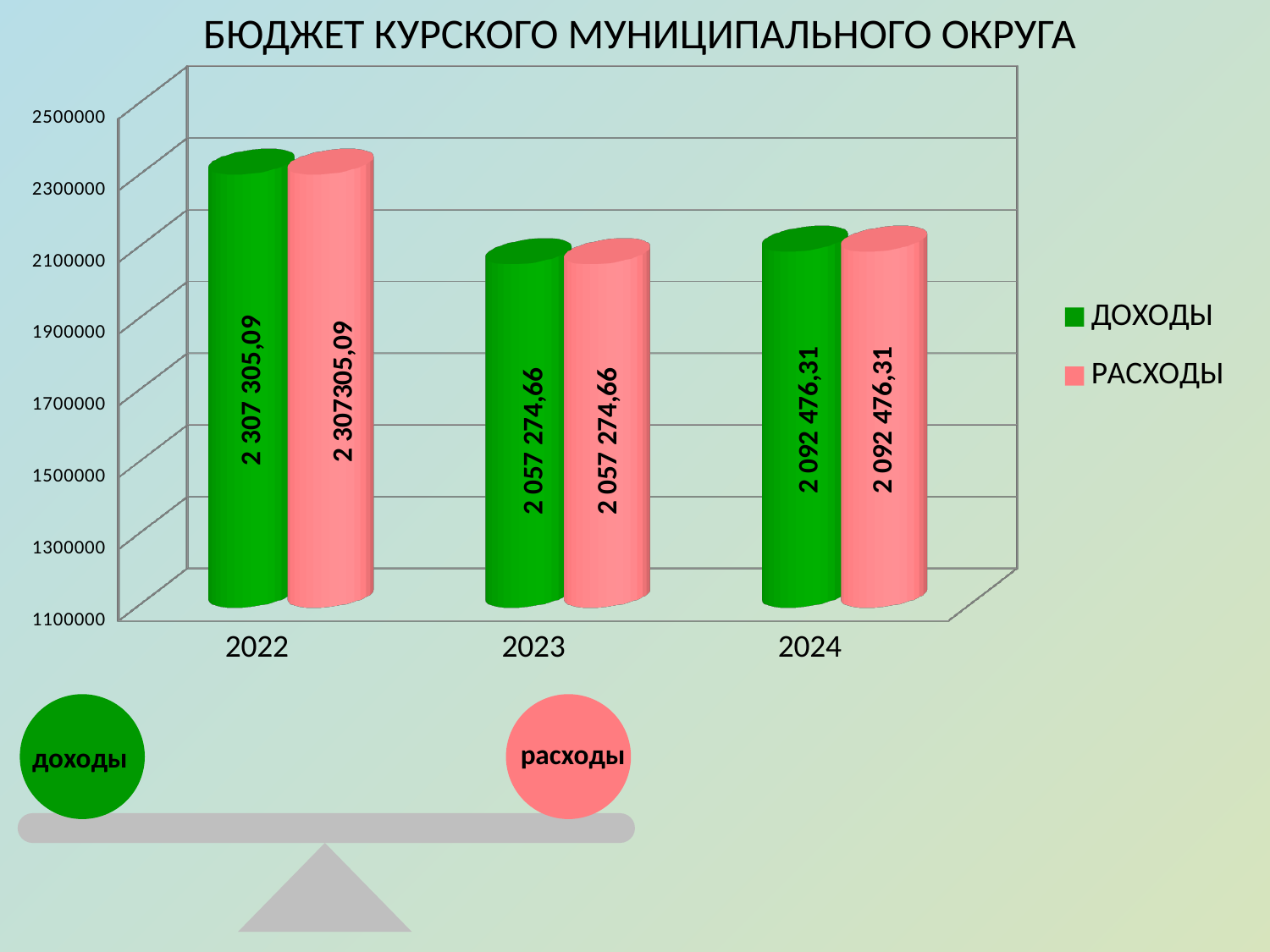
What is the value of ДОХОДЫ for 2024? 2 092 476,31 What is the value of РАСХОДЫ for 2023? 2 057 274,66 What is the difference between the РАСХОДЫ values for 2024 and 2023? 35 201,65 How many years are shown on the x axis? 3 Which year has the lowest РАСХОДЫ value? 2023 How many series does the legend list? 2 Is the value of РАСХОДЫ for 2022 greater or less than 2100000? greater What kind of chart is shown on the slide? Bar chart What is the value of ДОХОДЫ for 2022? 2 307 305,09 Which is larger: ДОХОДЫ for 2022 or ДОХОДЫ for 2024? ДОХОДЫ for 2022 Which year has the highest ДОХОДЫ value? 2022 What is the difference between the ДОХОДЫ values for 2022 and 2023? 250 030,43